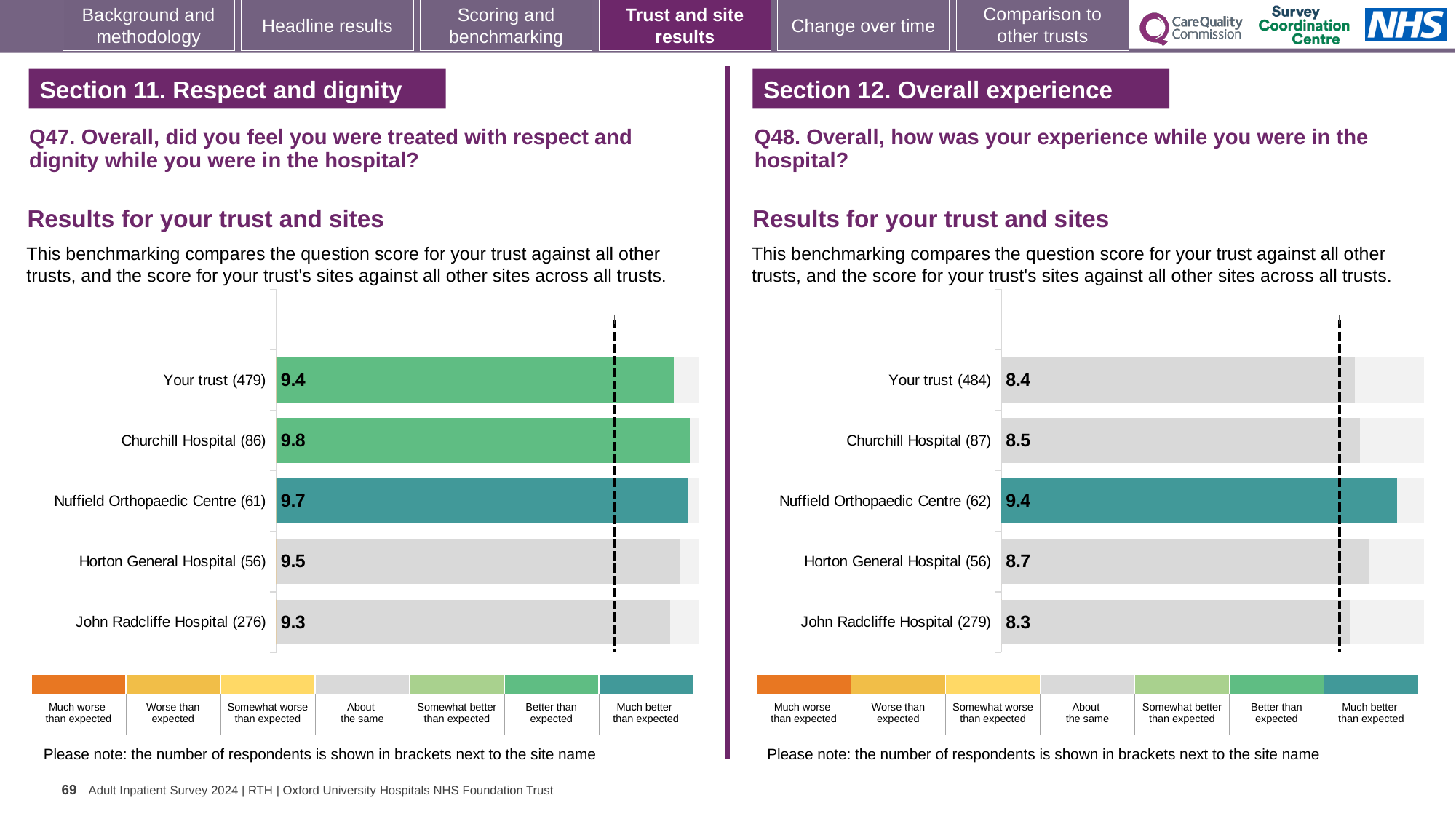
In the Q48 chart (right), what is the score for Nuffield Orthopaedic Centre? 9.4 What kind of chart is used for the Q48 results (right)? Bar chart In the Q47 chart (left), what is the score for John Radcliffe Hospital? 9.3 In the Q48 chart (right), which has the larger score, Churchill Hospital or Horton General Hospital? Horton General Hospital In the Q47 chart (left), what is the score for Churchill Hospital? 9.8 In the Q48 chart (right), which site or trust has the lowest score? John Radcliffe Hospital In the Q47 chart (left), what is the difference between the scores for Churchill Hospital and Your trust? 0.4 In the Q47 chart (left), which site or trust has the highest score? Churchill Hospital In the Q48 chart (right), what is the score for Horton General Hospital? 8.7 In the Q48 chart (right), which site or trust has the highest score? Nuffield Orthopaedic Centre In the Q47 chart (left), which site or trust has the lowest score? John Radcliffe Hospital How many bars are plotted in the Q47 chart (left)? 5